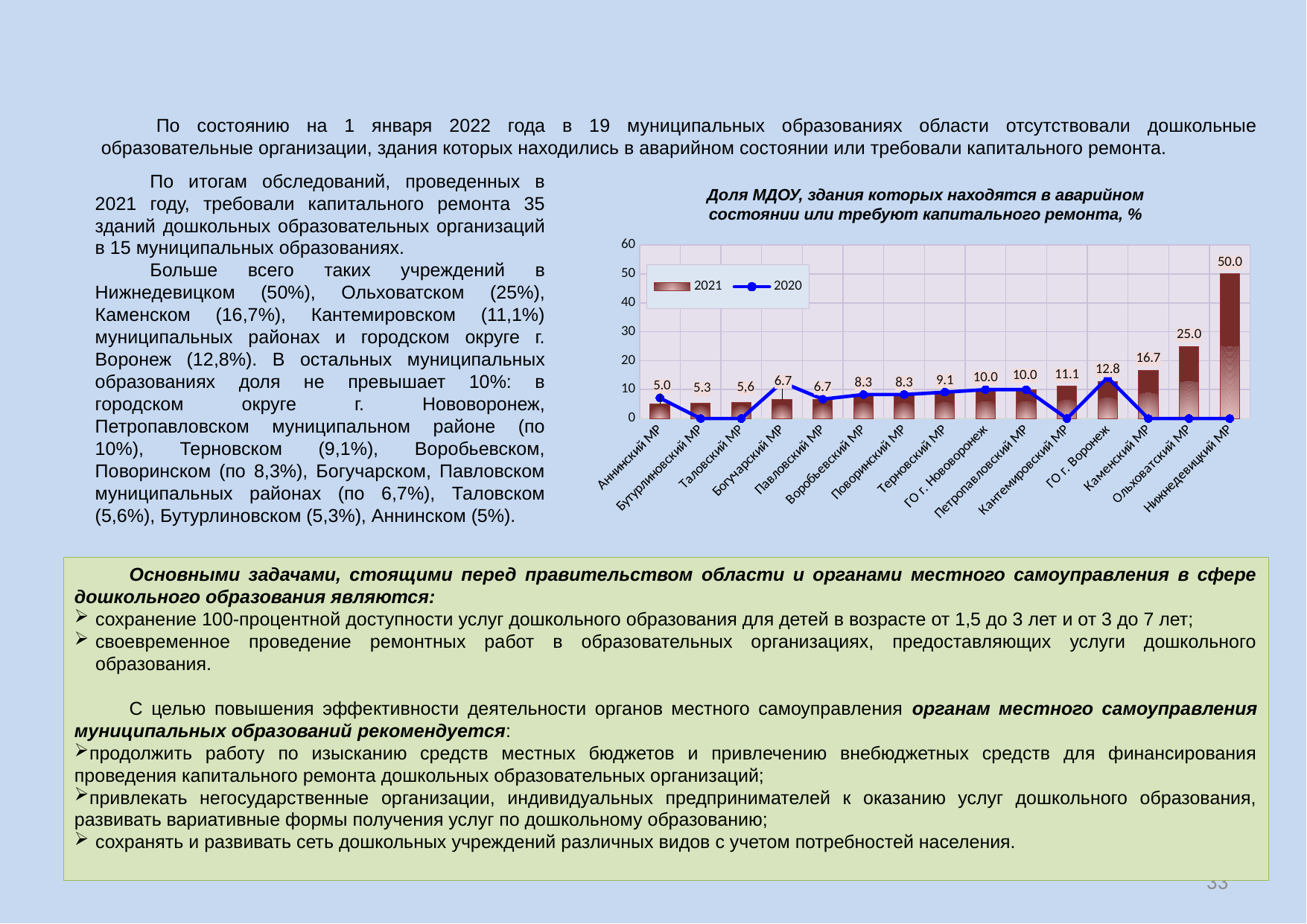
What is the difference between the 2021 values for Нижнедевицкий МР and Ольховатский МР? 25.0 What kind of chart is used for the 2021 series? bar chart How many series does the chart legend list? 2 Which municipality has the lowest 2021 value? Аннинский МР What is the 2021 value for ГО г. Воронеж? 12.8 Which has the larger 2021 value, Каменский МР or Кантемировский МР? Каменский МР Which municipality has the highest 2021 value? Нижнедевицкий МР Is the 2021 value for Ольховатский МР greater or less than 20? greater What is the 2021 value for Нижнедевицкий МР? 50.0 How many municipalities are shown on the x axis of the chart? 15 What is the 2021 value for Каменский МР? 16.7 Which years are listed in the chart legend? 2021 and 2020